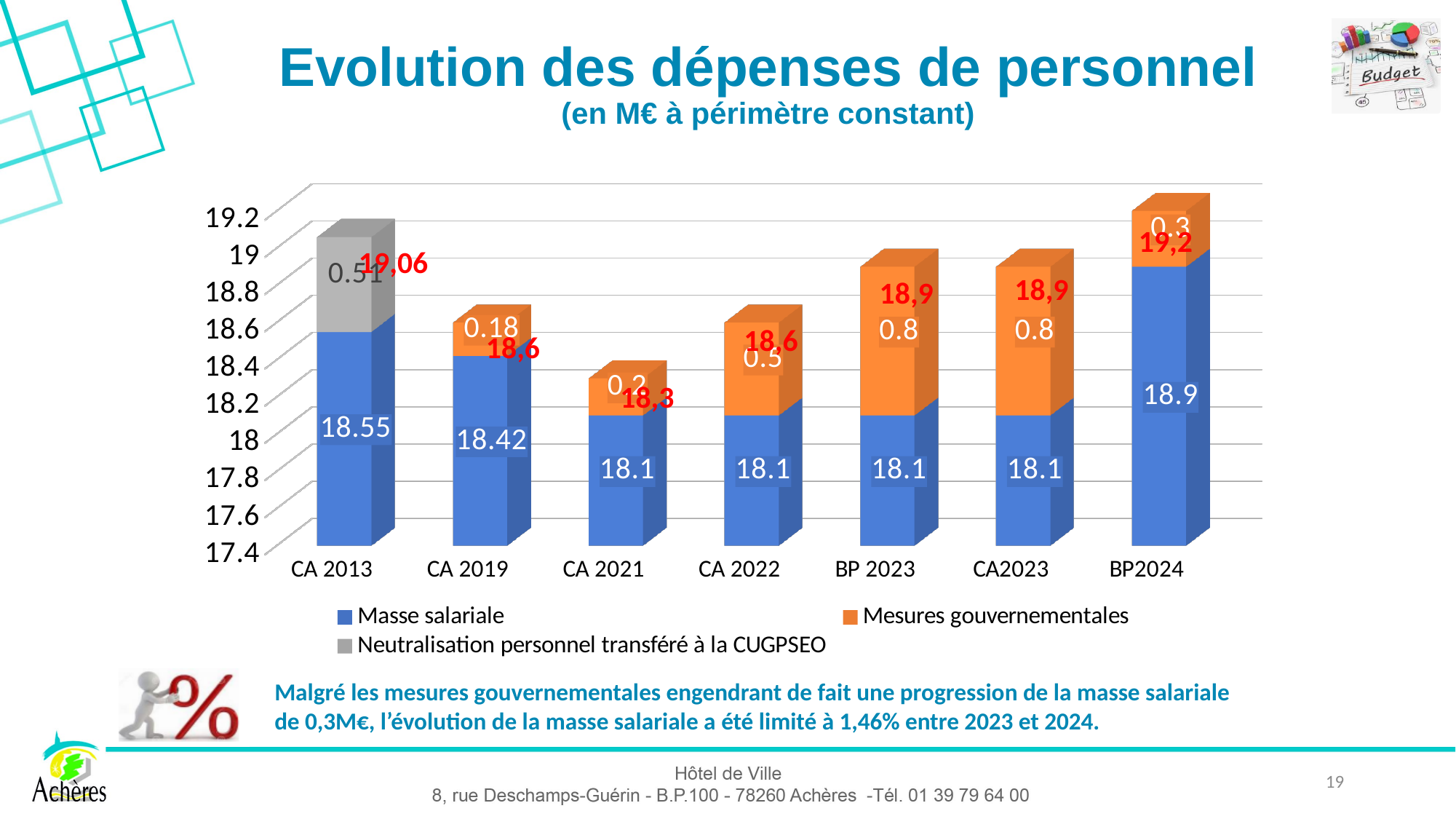
What is the difference between the Masse salariale values for CA 2013 and CA 2019? 0.13 What is the total printed in red for the BP2024 bar? 19,2 How many series does the legend list? 3 Which category has the lowest Mesures gouvernementales value? CA 2019 Which category has the highest Masse salariale value? BP2024 What kind of chart is shown on the slide? Stacked bar chart How many categories are shown on the x axis? 7 What is the Masse salariale value for BP2024? 18.9 What is the Mesures gouvernementales value for BP 2023? 0.8 What is the Masse salariale value for CA 2013? 18.55 What is the Neutralisation personnel transféré à la CUGPSEO value for CA 2013? 0.51 Is the Mesures gouvernementales value larger for CA 2022 or for CA2023? CA2023